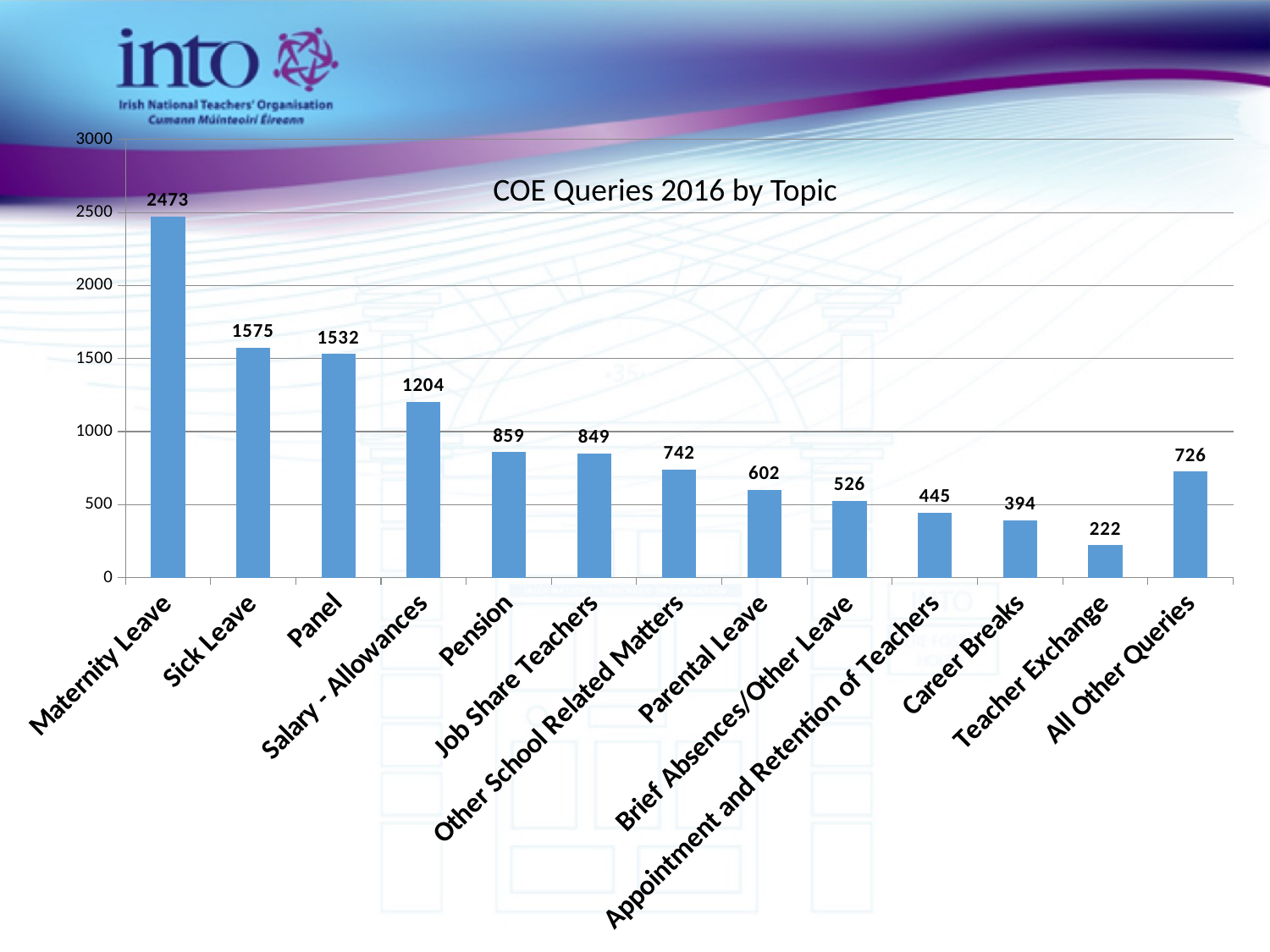
Which topic has the lowest number of queries? Teacher Exchange What kind of chart is this? bar chart What is the value for Salary - Allowances? 1204 What is the value for Teacher Exchange? 222 How many topics are shown on the chart? 13 What is the title of the chart? COE Queries 2016 by Topic Is the value for Parental Leave greater or less than 500? greater What is the difference between the values for Sick Leave and Panel? 43 What is the value for Maternity Leave? 2473 Which topic has the highest number of queries? Maternity Leave What is the difference between the values for Maternity Leave and All Other Queries? 1747 Which is larger, the value for Pension or the value for Job Share Teachers? Pension